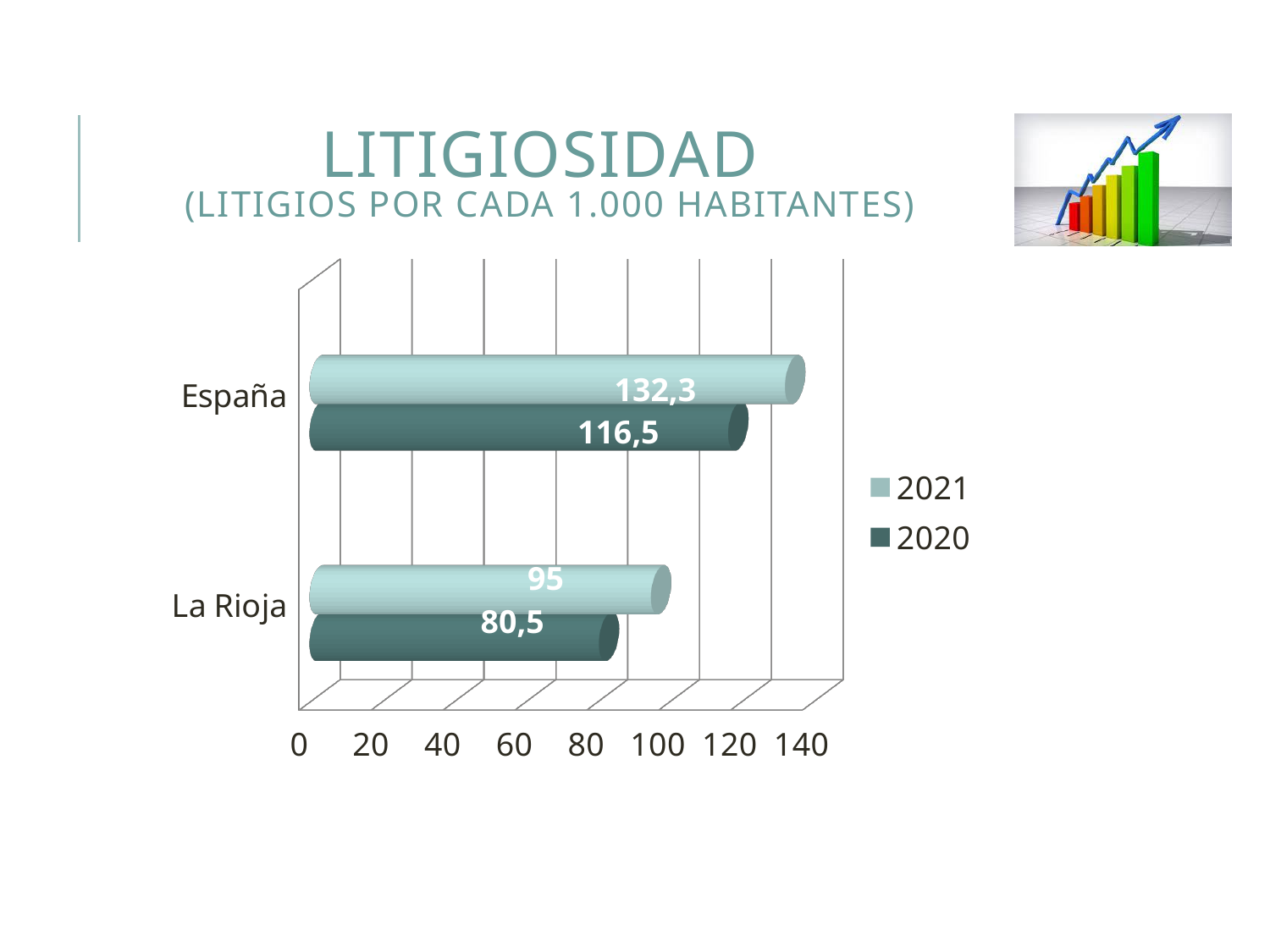
Which category has the lowest value in 2020? La Rioja What is the value for España in 2021? 132,3 Which is larger: the 2021 value for La Rioja or the 2020 value for España? 2020 value for España Which category has the highest value in 2021? España How many series does the legend list? 2 How many categories are shown on the chart? 2 What is the difference between the 2021 and 2020 values for España? 15,8 What is the value for España in 2020? 116,5 What is the value for La Rioja in 2021? 95 What kind of chart is shown on the slide? Bar chart What is the value for La Rioja in 2020? 80,5 What is the difference between the 2021 and 2020 values for La Rioja? 14,5